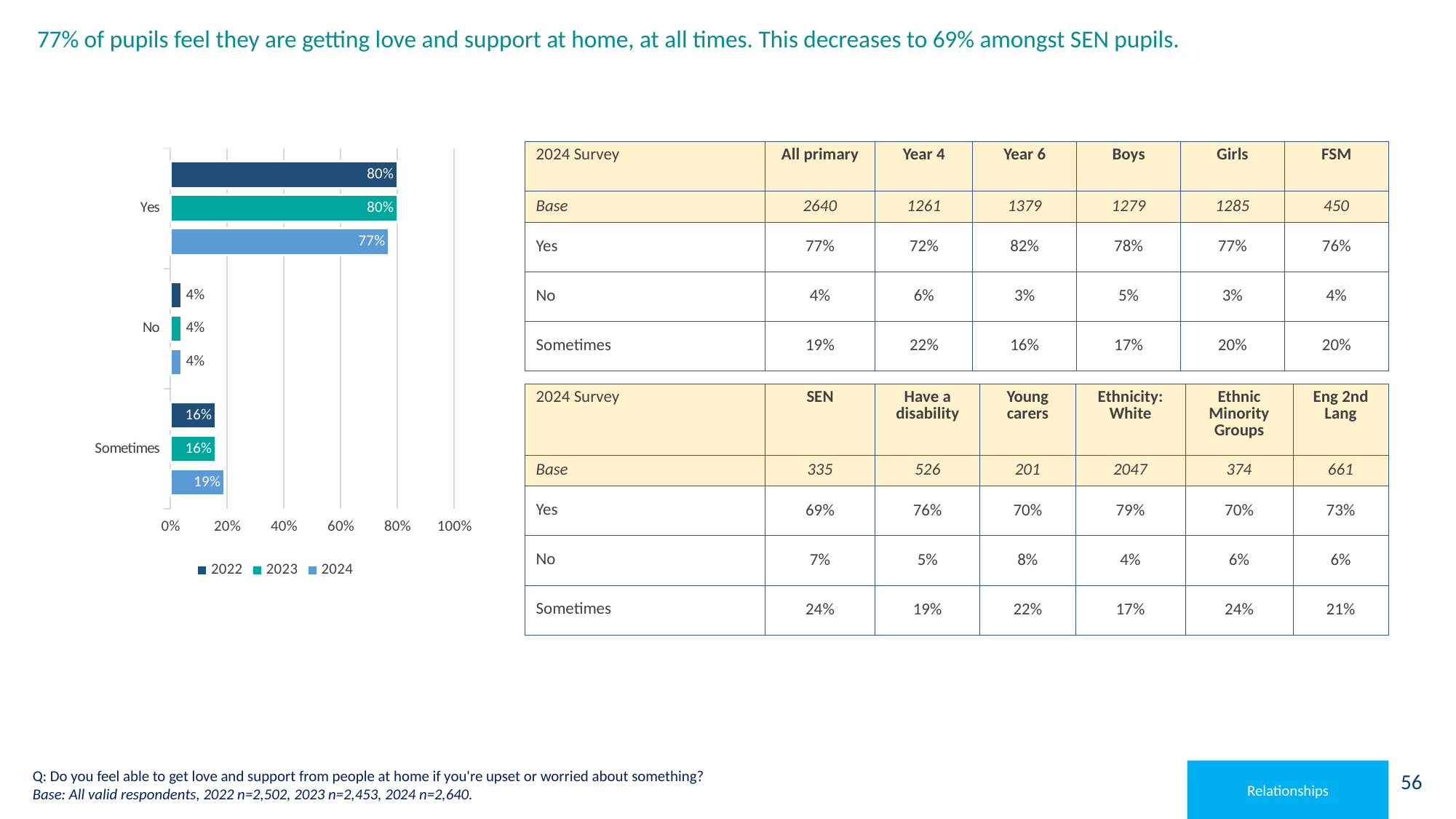
What is the value for Yes in 2024? 77% Which category has the lowest value in the 2023 series? No What is the value for Yes in 2022? 80% What kind of chart is shown on the slide? Bar chart What is the value for No in 2023? 4% Which is larger: Sometimes in 2024 or Sometimes in 2023? Sometimes in 2024 How many categories are shown on the chart? 3 What is the difference between the Yes values for 2023 and 2024? 3% How many series does the legend list? 3 What is the value for Sometimes in 2022? 16% Which category has the highest value in the 2024 series? Yes What is the difference between the Sometimes values for 2024 and 2022? 3%